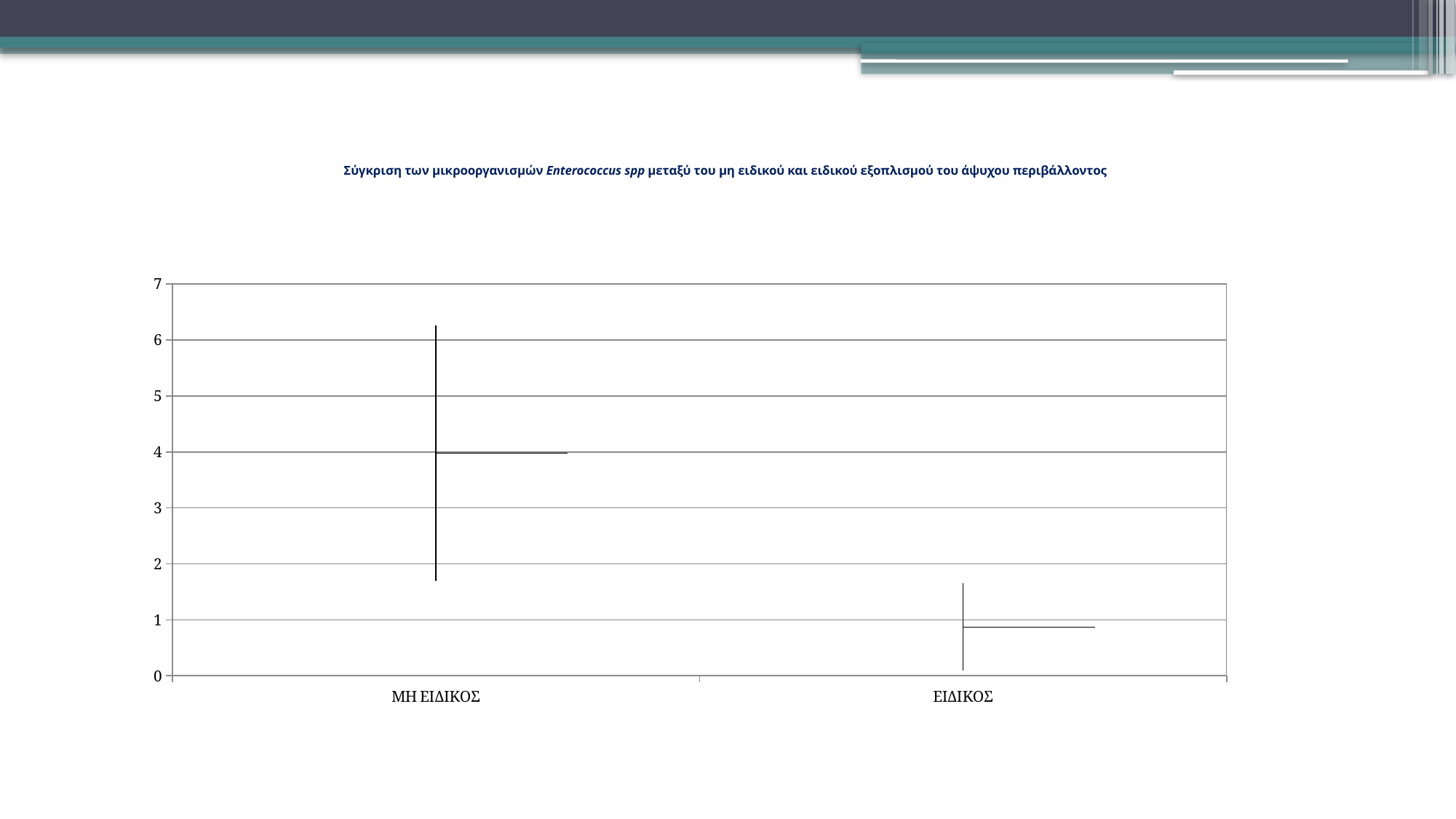
Is the upper end of the vertical line for ΜΗ ΕΙΔΙΚΟΣ greater or less than 6? greater Is the value for ΕΙΔΙΚΟΣ greater or less than 2? less Which category has the lower value in the chart? ΕΙΔΙΚΟΣ Which microorganism is named in the chart title? Enterococcus spp Is the value for ΜΗ ΕΙΔΙΚΟΣ greater or less than 3? greater Which category has the higher value in the chart? ΜΗ ΕΙΔΙΚΟΣ What is the highest value shown on the y axis of the chart? 7 Do the values rise or fall from ΜΗ ΕΙΔΙΚΟΣ to ΕΙΔΙΚΟΣ along the x axis? fall Is the value for ΜΗ ΕΙΔΙΚΟΣ larger or smaller than the value for ΕΙΔΙΚΟΣ? larger How many categories are shown on the x axis of the chart? 2